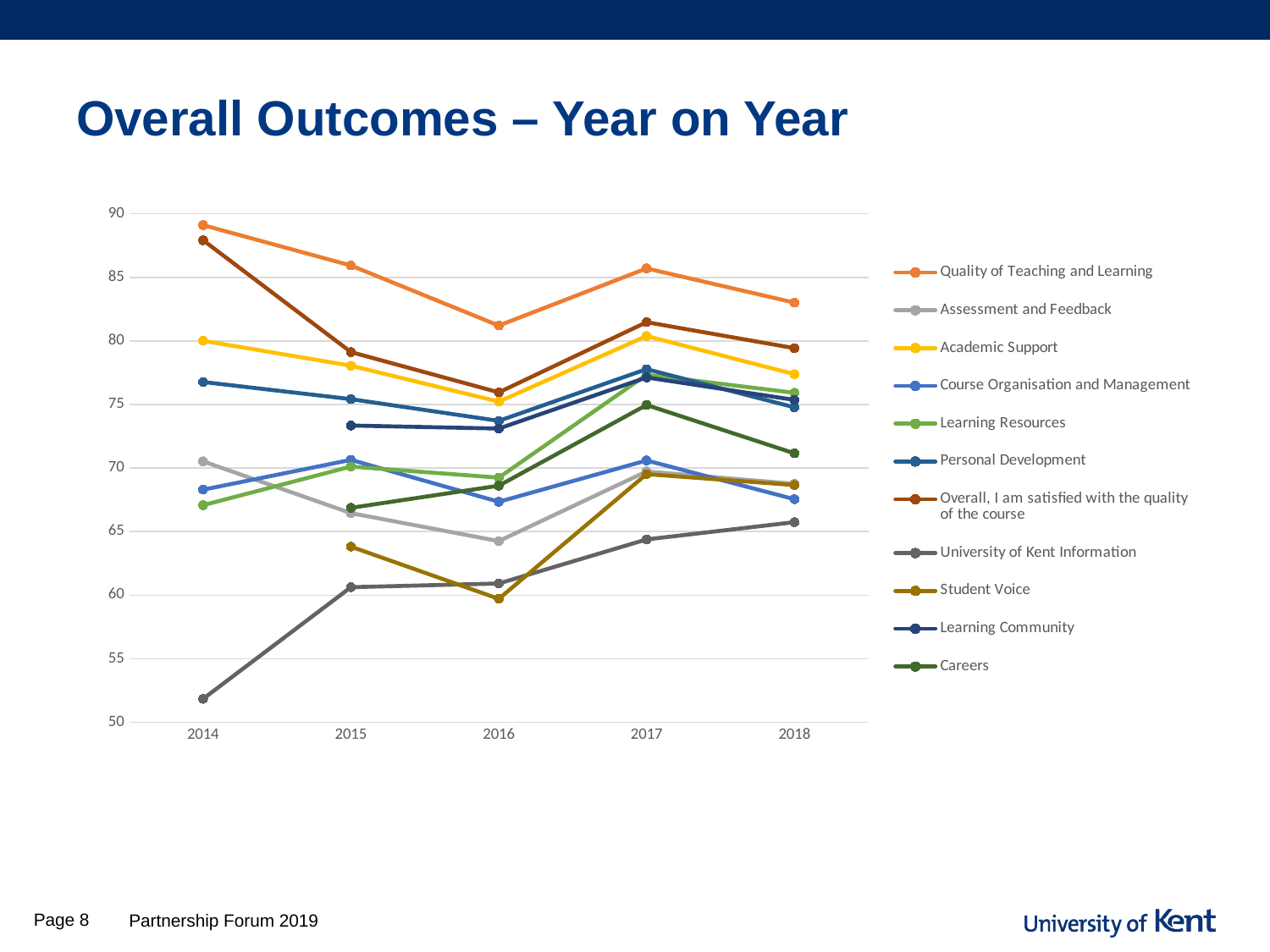
What kind of chart is shown on the slide? Line chart How many series does the legend list? 11 Is the value for Quality of Teaching and Learning in 2014 greater or less than 85? greater Which series has the highest value in 2016? Quality of Teaching and Learning Which series has the lowest value in 2014? University of Kent Information Is the value for Careers in 2017 greater or less than 70? greater In 2018, which is larger: Learning Resources or Careers? Learning Resources Is the value for University of Kent Information in 2014 greater or less than 55? less Does the Quality of Teaching and Learning series rise or fall from 2014 to 2016? fall What is the title of the slide containing the chart? Overall Outcomes – Year on Year How many years are shown along the x axis? 5 Does the University of Kent Information series rise or fall from 2014 to 2018? rise